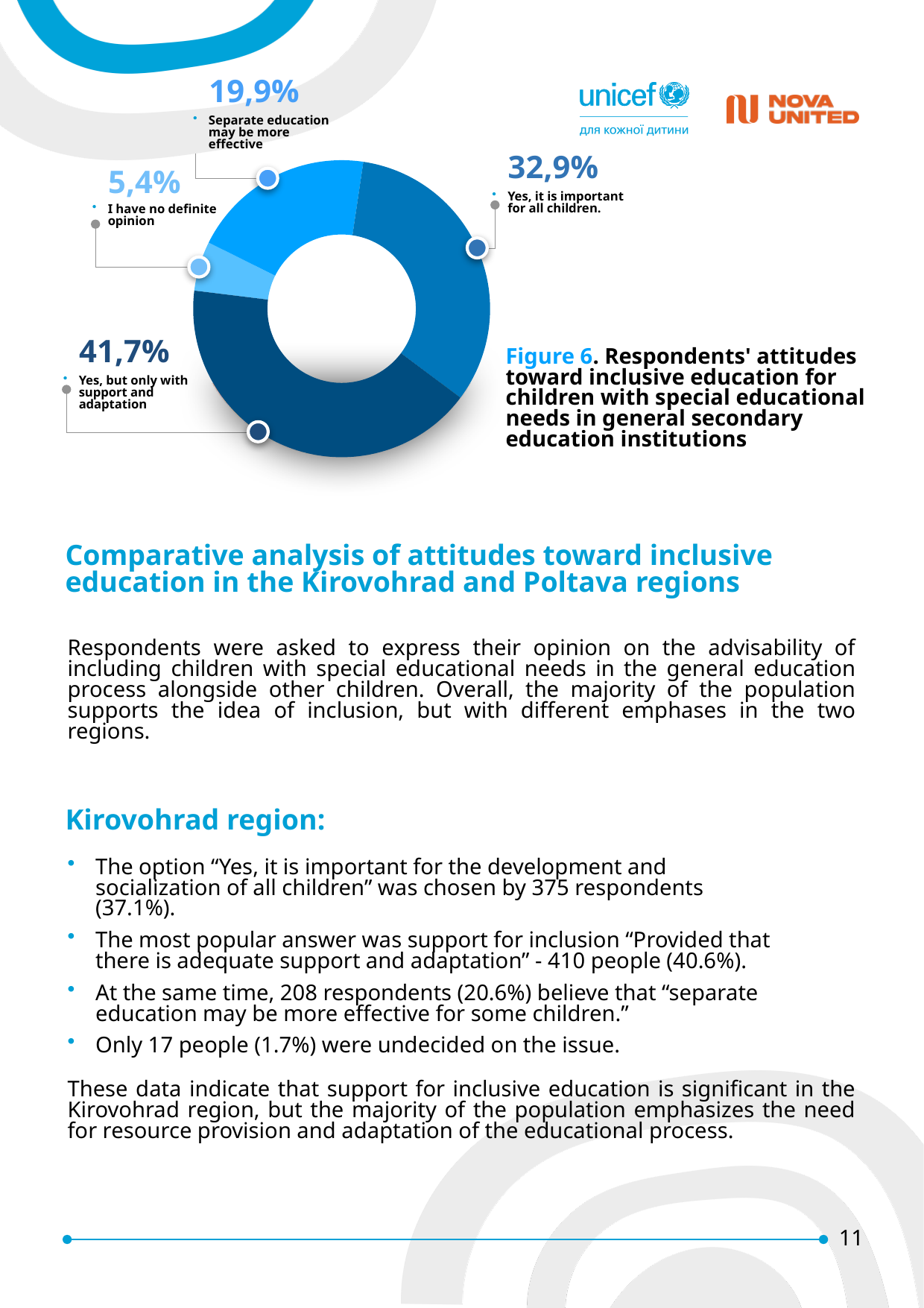
What is the combined share of the two "Yes" responses in the chart? 74,6% What is the difference in percentage points between "Yes, but only with support and adaptation" and "Yes, it is important for all children"? 8,8 percentage points What share of respondents answered "Yes, but only with support and adaptation"? 41,7% Which response has the smallest share in the chart? I have no definite opinion What share of respondents answered "I have no definite opinion"? 5,4% What share of respondents answered "Yes, it is important for all children"? 32,9% Which response has the largest share in the chart? Yes, but only with support and adaptation What share of respondents answered "Separate education may be more effective"? 19,9% Which is larger: the share for "Separate education may be more effective" or the share for "I have no definite opinion"? Separate education may be more effective How many response categories does the chart show? 4 What is the figure number of the chart on the slide? Figure 6 What kind of chart is shown in Figure 6? Pie chart (donut)